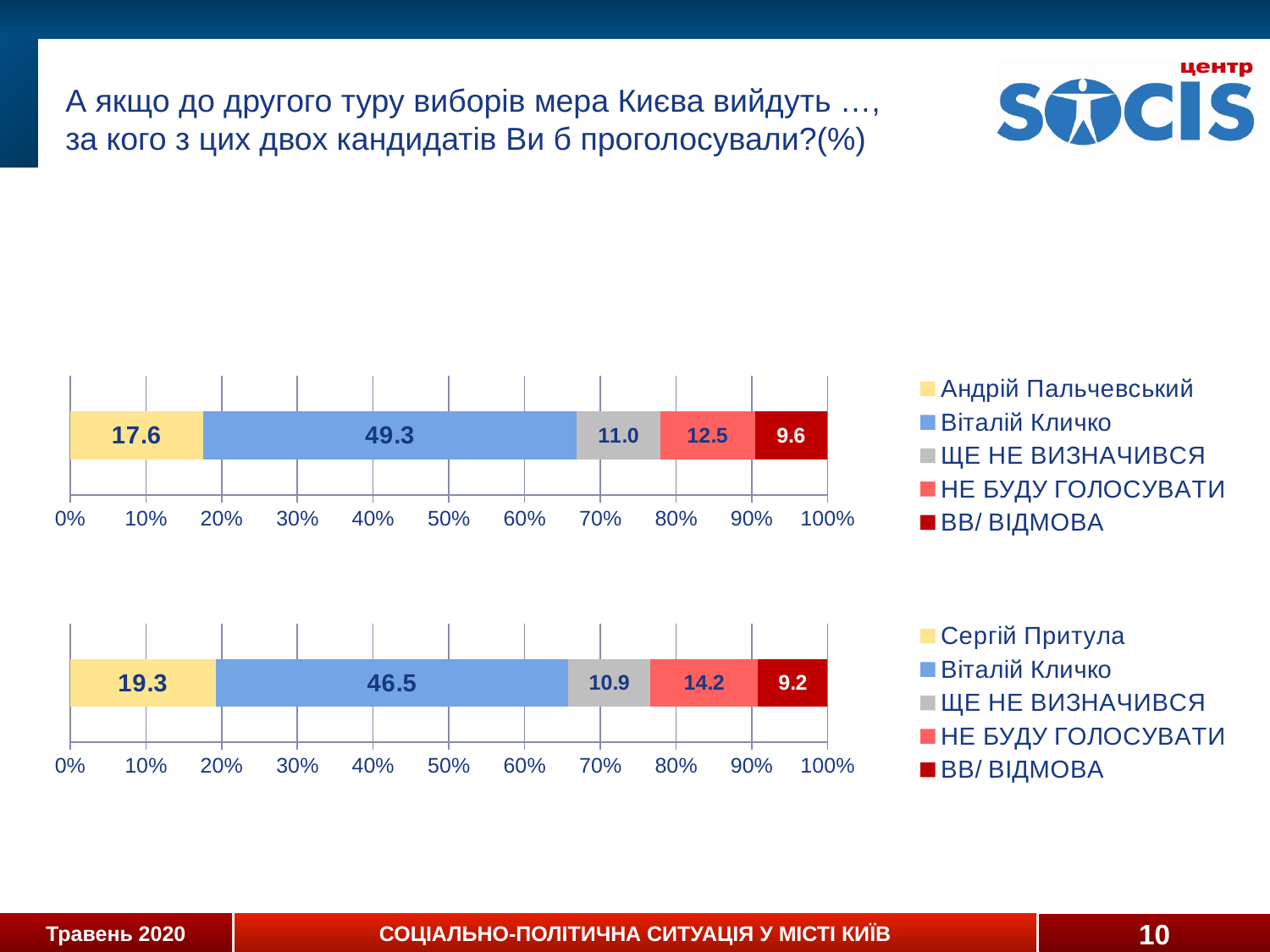
In the bottom chart (Притула vs Кличко), what is the value for Сергій Притула? 19.3 How many series does the legend of the bottom chart list? 5 In the top chart, what is the value for Андрій Пальчевський? 17.6 In the bottom chart, which segment has the smallest value? ВВ/ ВІДМОВА What type of chart is used on this slide? Stacked bar chart In the top chart, what is the difference between the values for Віталій Кличко and Андрій Пальчевський? 31.7 In the top chart (Пальчевський vs Кличко), what is the value for Віталій Кличко? 49.3 In the bottom chart, which is larger: the value for ЩЕ НЕ ВИЗНАЧИВСЯ or the value for НЕ БУДУ ГОЛОСУВАТИ? НЕ БУДУ ГОЛОСУВАТИ In the bottom chart, what is the total of the stacked bar? 100.1 In the top chart, what colour is the segment for ВВ/ ВІДМОВА? Dark red In the bottom chart, what is the value for НЕ БУДУ ГОЛОСУВАТИ? 14.2 In the top chart, which segment has the largest value? Віталій Кличко